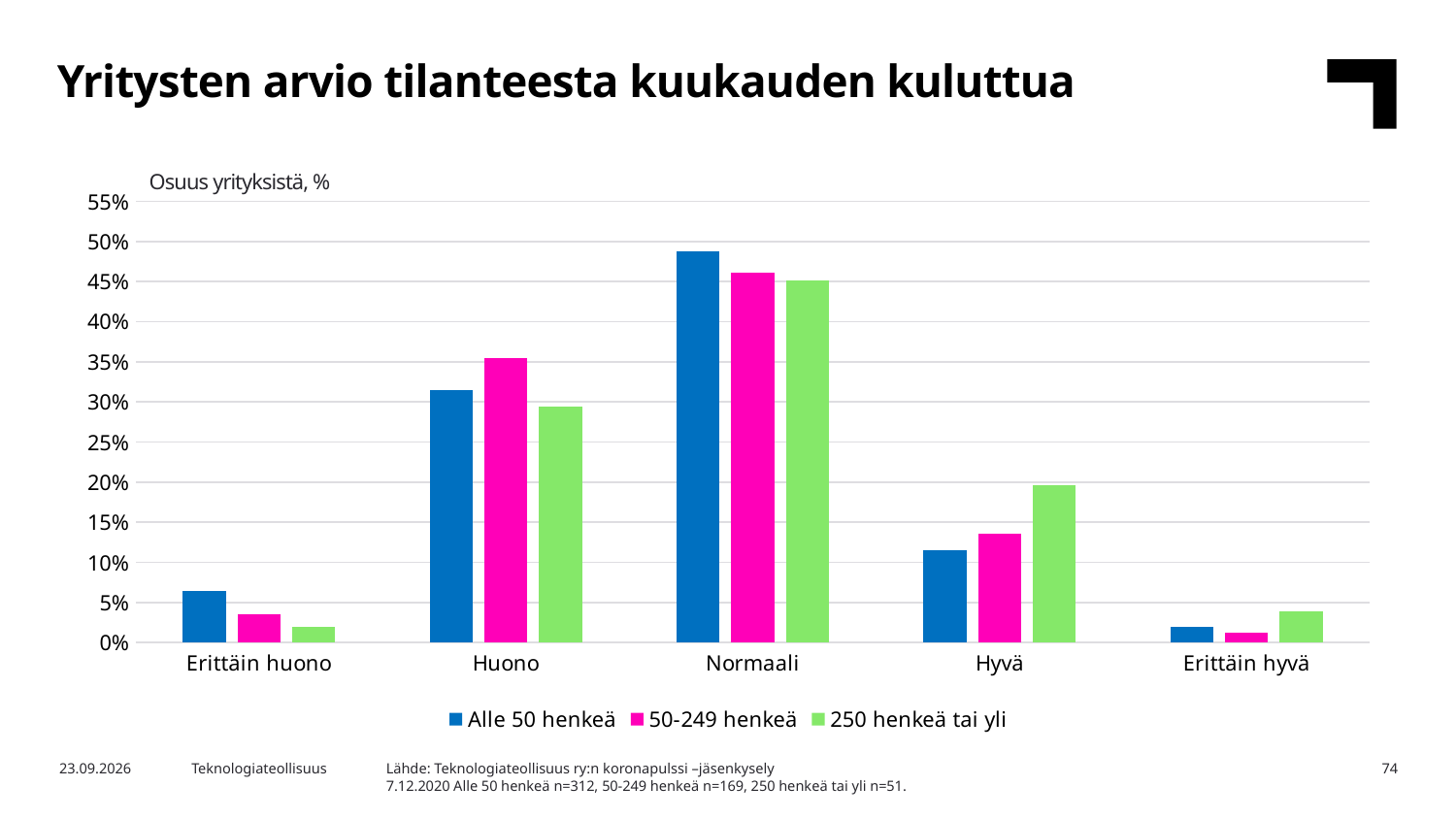
For the category Huono, which series has the larger value: Alle 50 henkeä or 50-249 henkeä? 50-249 henkeä Is the value for Huono in the series 50-249 henkeä greater or less than 30%? greater What kind of chart is shown on the slide? Bar chart What is the label shown above the vertical axis of the chart? Osuus yrityksistä, % Which category has the highest value for the series Alle 50 henkeä? Normaali Is the value for Erittäin huono in the series Alle 50 henkeä greater or less than 5%? greater Which category has the lowest value for the series 50-249 henkeä? Erittäin hyvä How many series does the legend list? 3 Is the value for Normaali in the series Alle 50 henkeä greater or less than 45%? greater How many categories are shown on the x axis of the chart? 5 For the category Hyvä, which series has the larger value: Alle 50 henkeä or 250 henkeä tai yli? 250 henkeä tai yli